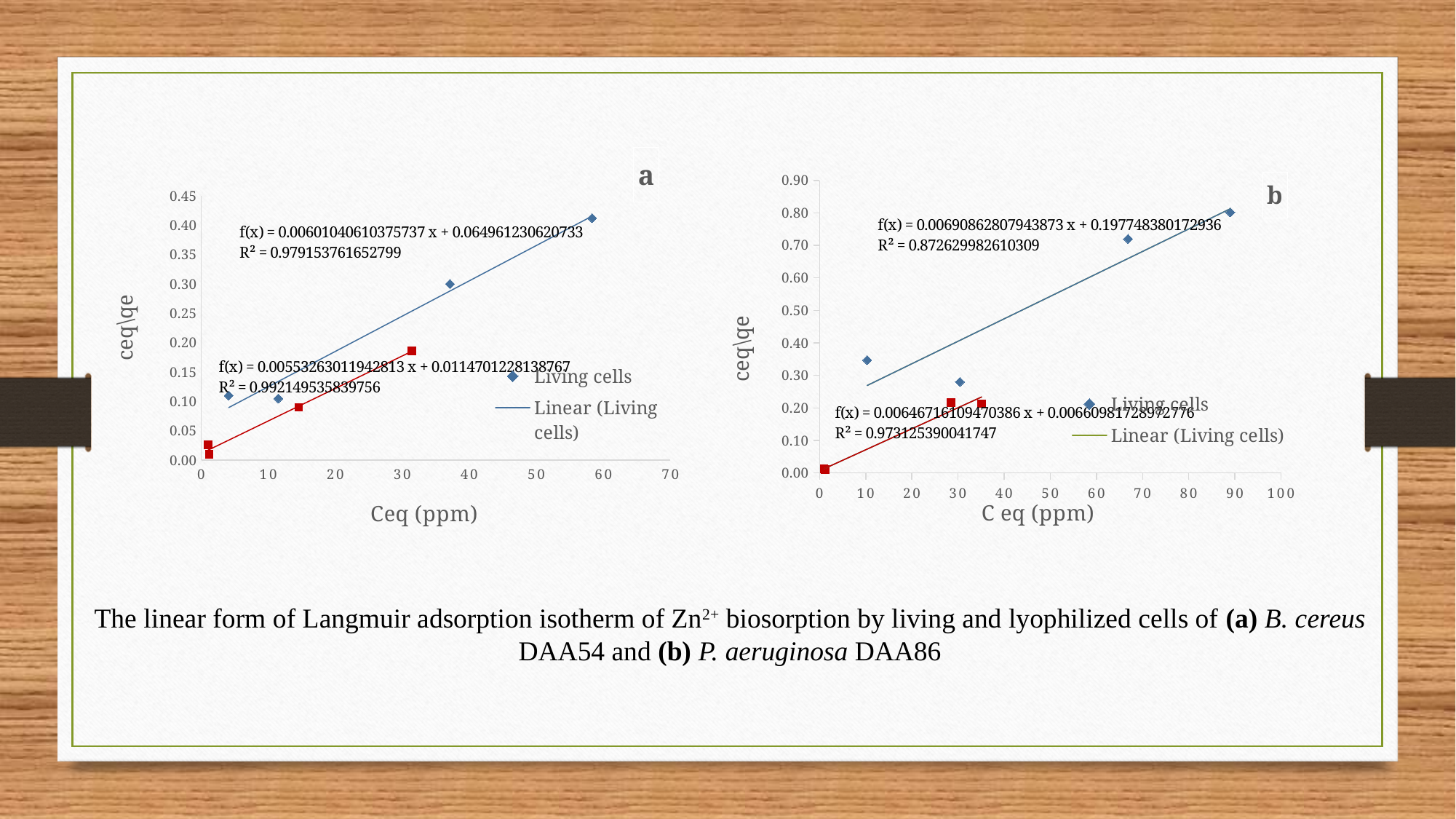
In chart b, is the ceq\qe value of the Living cells point near C eq 10 ppm greater or less than 0.40? less In chart b, what is the R² value printed for the Living cells (blue) trendline? 0.872629982610309 In chart b, is the ceq\qe value of the highest Living cells point (near C eq 89 ppm) greater or less than 0.70? greater Which two entries does the legend of chart b list? Living cells and Linear (Living cells) In chart a, is the ceq\qe value of the highest Living cells point (near Ceq 58 ppm) greater or less than 0.35? greater What kind of chart is chart a on the left of the slide? Scatter chart with linear trendlines In chart a, do the ceq\qe values for the Living cells series rise or fall as Ceq (ppm) increases? Rise What is the x-axis title of chart a? Ceq (ppm) In chart a, what is the R² value printed for the Living cells (blue) trendline? 0.979153761652799 In chart b, do the ceq\qe values for the Living cells series rise or fall as C eq (ppm) increases? Rise In chart a, which trendline has the higher R², the blue Living cells line or the red square series line? The red square series line In chart a, how many blue diamond (Living cells) data points are plotted? 4